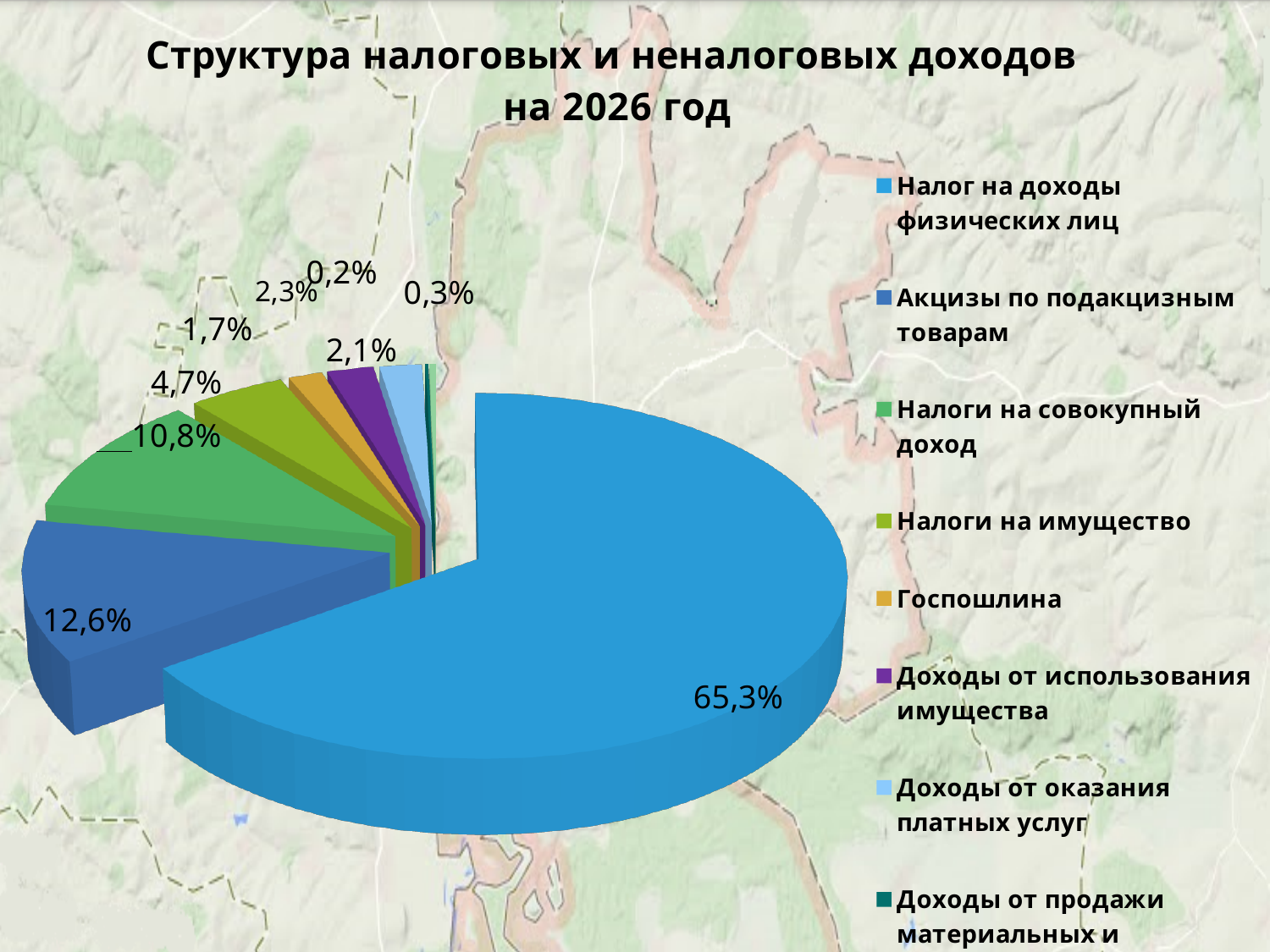
Which category has the largest slice of the pie? Налог на доходы физических лиц What is the value for Налоги на имущество? 4,7% Which is larger: Налоги на совокупный доход or Налоги на имущество? Налоги на совокупный доход What share is shown for Госпошлина? 1,7% What is the title of the chart? Структура налоговых и неналоговых доходов на 2026 год What is the difference between Акцизы по подакцизным товарам and Налоги на совокупный доход? 1,8% What percentage is shown for Доходы от использования имущества? 2,3% What is the value shown for Акцизы по подакцизным товарам? 12,6% What kind of chart is shown on the slide? Pie chart What share of the pie does Налог на доходы физических лиц account for? 65,3% What percentage is shown for Налоги на совокупный доход? 10,8% By how many percentage points does Налог на доходы физических лиц exceed Акцизы по подакцизным товарам? 52,7%